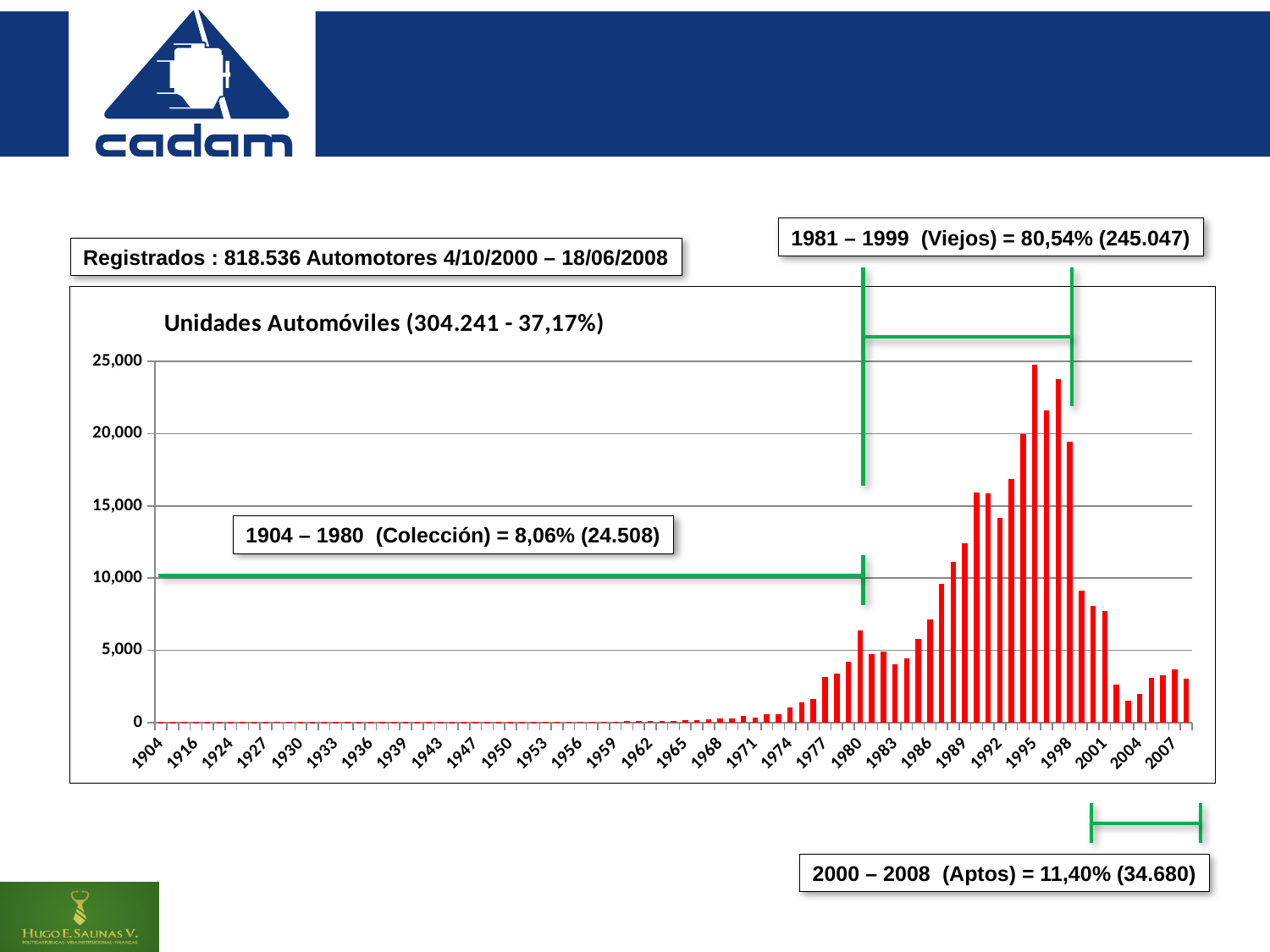
Is the value for 1974 greater or less than 5,000? less Do the values rise or fall from 1998 to 2001? fall Is the value for 1950 greater or less than 5,000? less According to the annotation on the slide, what percentage corresponds to 1981 – 1999 (Viejos)? 80,54% Which year has the larger value, 1998 or 2007? 1998 Is the value for 1980 greater or less than 5,000? greater Which year has the larger value, 1995 or 2001? 1995 What is the title of the chart? Unidades Automóviles (304.241 - 37,17%) What kind of chart is shown on the slide? bar chart